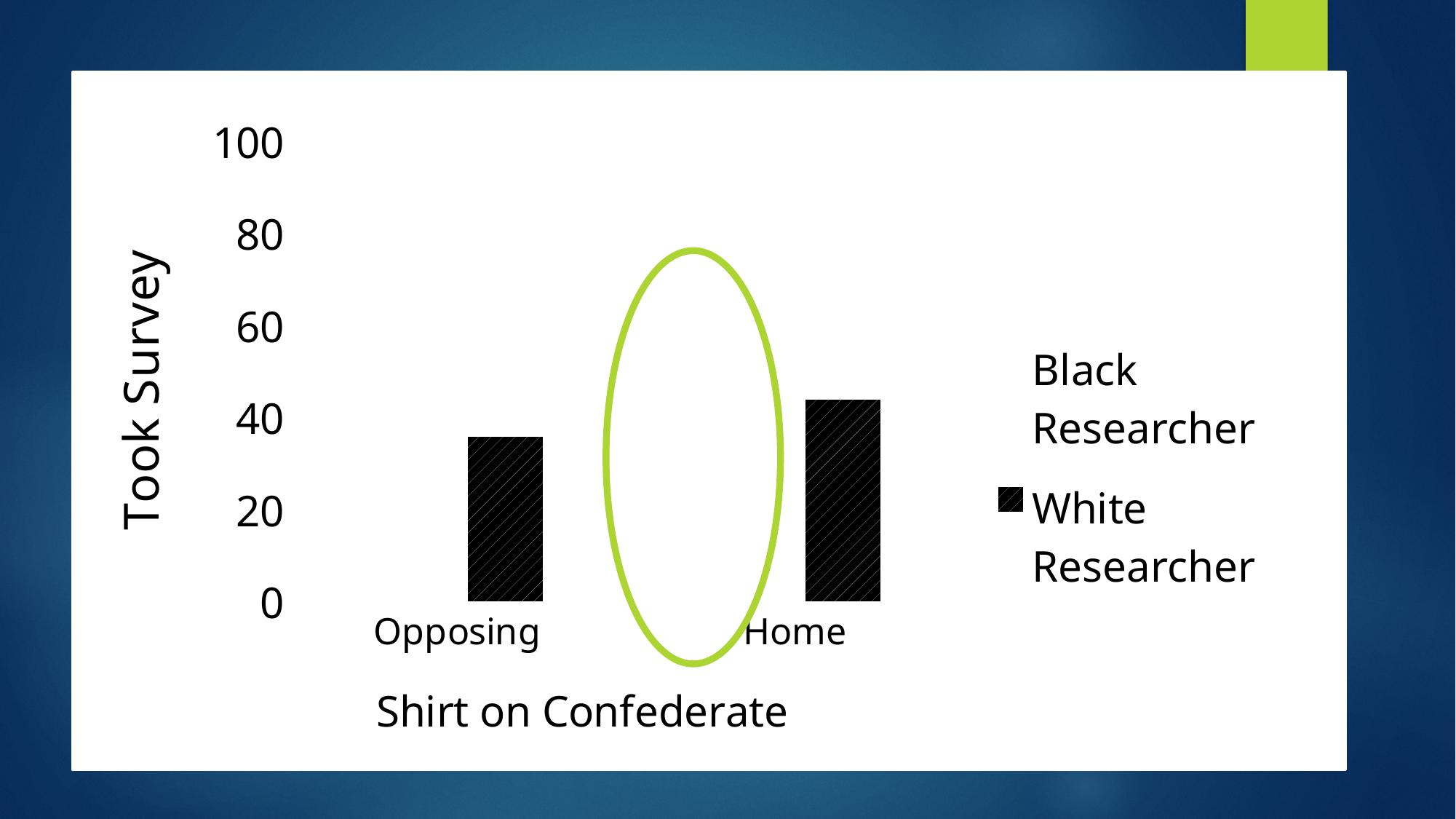
Is the White Researcher value for Home greater or less than 40? greater Which category has the highest White Researcher bar? Home Is the White Researcher value for Home greater or less than 60? less What is the title of the horizontal axis of the chart? Shirt on Confederate Which category has the lowest White Researcher bar? Opposing What kind of chart is shown on the slide? bar chart What is the title of the vertical axis of the chart? Took Survey How many categories are shown on the x axis of the chart? 2 Which category has the taller White Researcher bar, Opposing or Home? Home Do the White Researcher bars rise or fall from Opposing to Home? rise How many series does the chart's legend list? 2 Is the White Researcher value for Opposing greater or less than 40? less